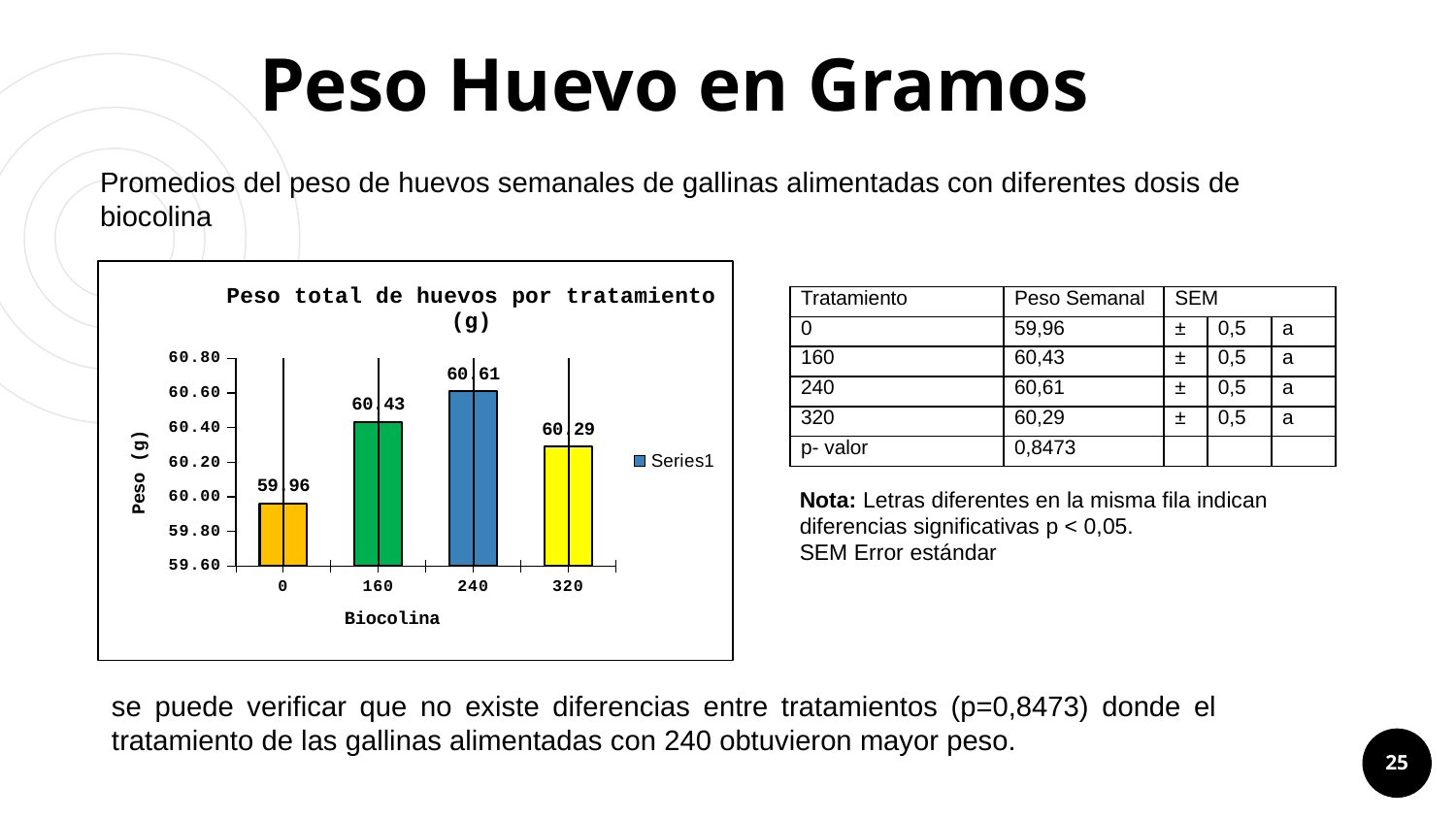
Which biocolina treatment has the lowest egg weight? 0 Which biocolina treatment has the highest egg weight? 240 What is the egg weight value for the 160 biocolina treatment? 60.43 How many biocolina treatments are shown on the x axis? 4 Which has a higher egg weight, the 160 treatment or the 320 treatment? 160 What is the egg weight value for the 240 biocolina treatment? 60.61 What is the egg weight value for the 320 biocolina treatment? 60.29 What is the title of the chart? Peso total de huevos por tratamiento (g) What is the egg weight value for the 0 biocolina treatment? 59.96 What is the difference between the egg weight for the 240 treatment and the 0 treatment? 0.65 How many series does the legend list? 1 What kind of chart is shown on the slide? Bar chart